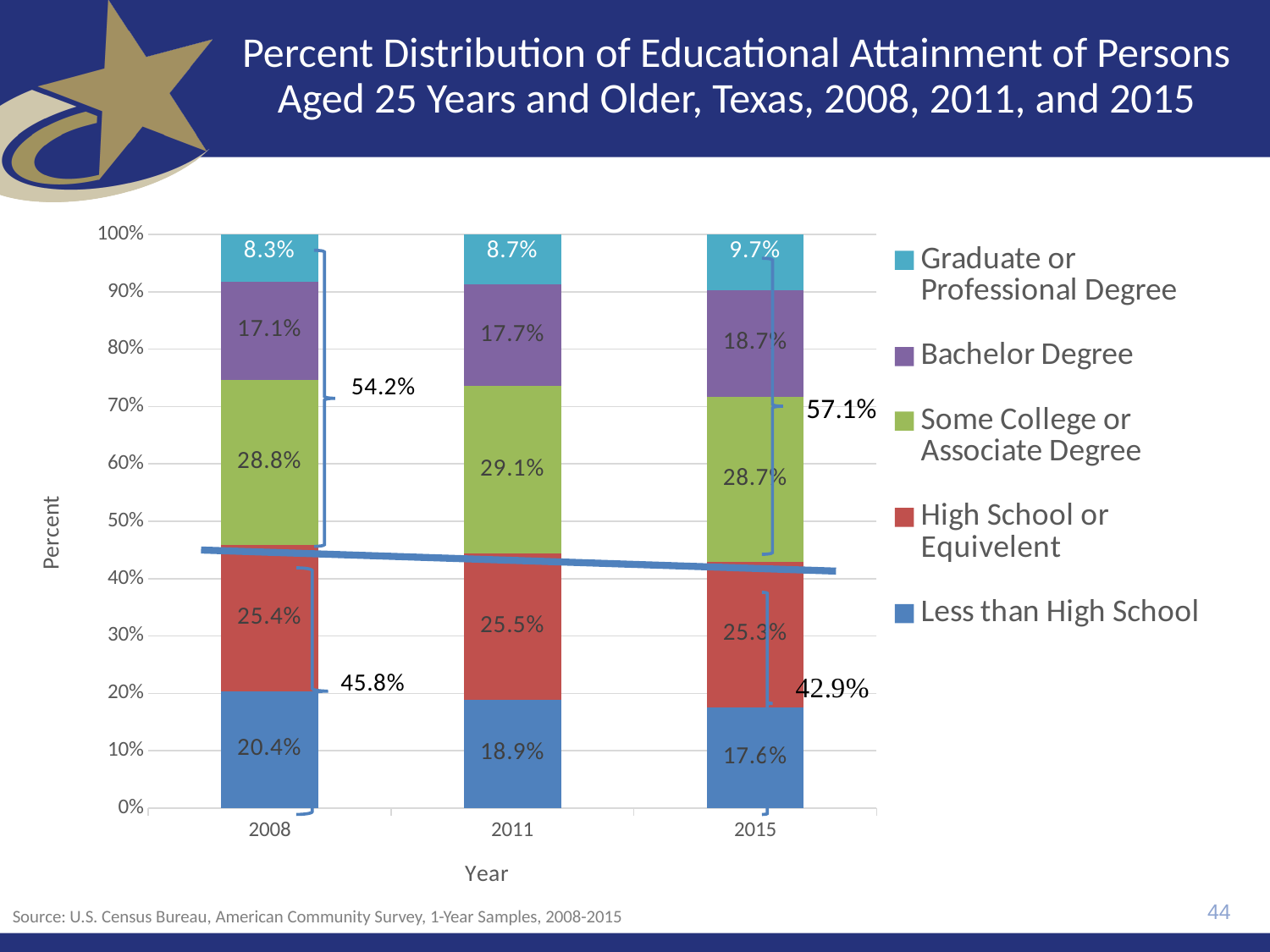
Does the Less than High School share rise or fall from 2008 to 2015? Fall What is the value for Graduate or Professional Degree in 2015? 9.7% By how many percentage points did the Less than High School share fall from 2008 to 2015? 2.8 percentage points What kind of chart is shown on the slide? Stacked bar chart How many series does the legend list? 5 What is the value for Bachelor Degree in 2011? 17.7% Which year has the larger Graduate or Professional Degree share, 2008 or 2015? 2015 Does the Graduate or Professional Degree share rise or fall from 2008 to 2015? Rise How many years are shown on the x axis? 3 What percentage of persons aged 25 and older in Texas had less than a high school education in 2008? 20.4% Which educational attainment category has the smallest share in 2008? Graduate or Professional Degree Which educational attainment category has the largest share in 2011? Some College or Associate Degree